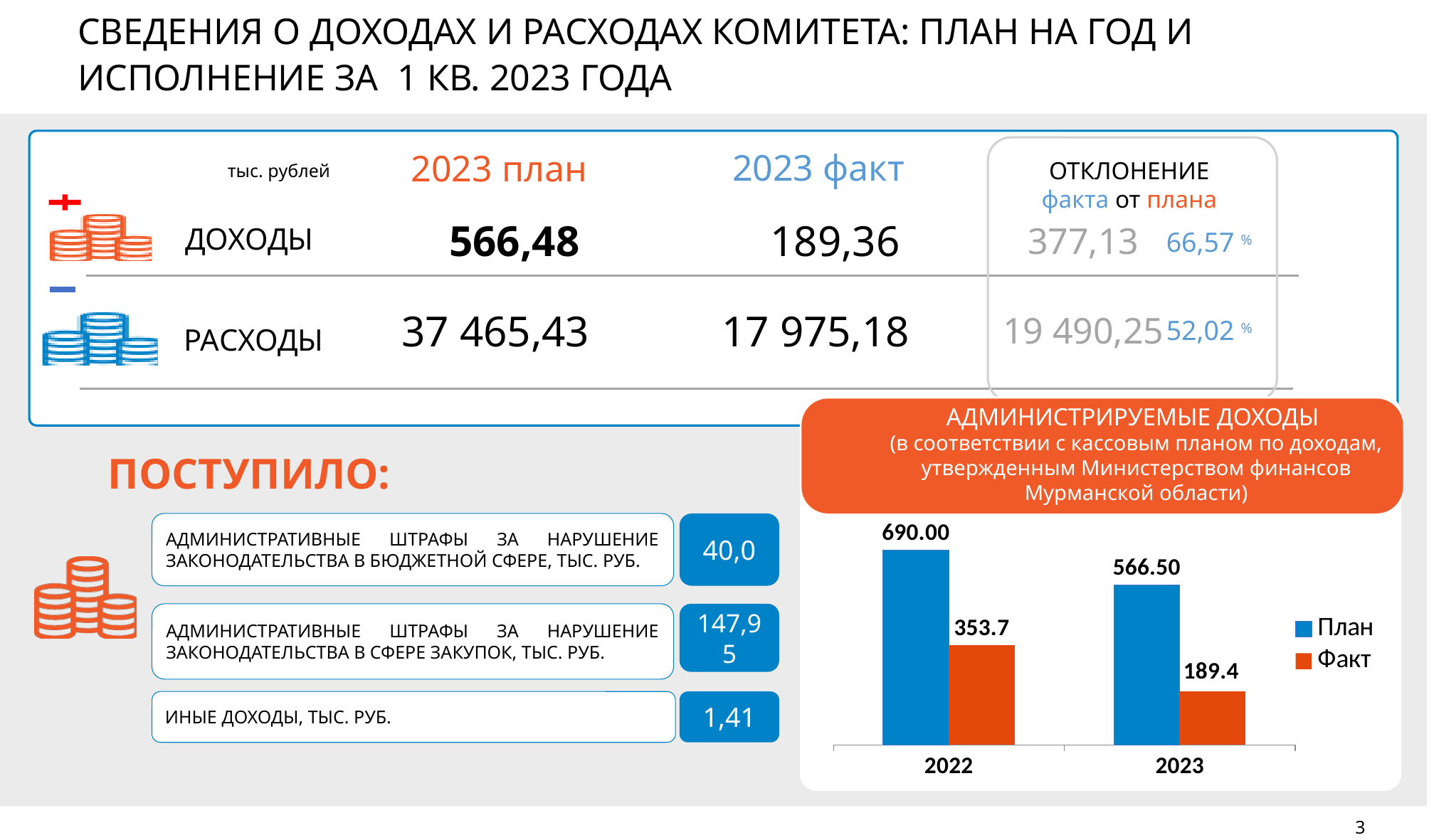
In the bar chart, what is the value of 'План' for 2023? 566.50 In the bar chart, what is the value of 'Факт' for 2022? 353.7 How many series does the legend of the bar chart list? 2 In the bar chart, which year has the lowest 'Факт' value? 2023 In the bar chart, does the 'План' series rise or fall from 2022 to 2023? fall What type of chart is shown under the heading 'АДМИНИСТРИРУЕМЫЕ ДОХОДЫ'? bar chart In the bar chart, is the 'Факт' value for 2022 larger or smaller than the 'Факт' value for 2023? larger In the bar chart, what is the difference between 'План' and 'Факт' for 2022? 336.3 In the bar chart, which year has the highest 'План' value? 2022 In the bar chart, what is the value of 'Факт' for 2023? 189.4 How many categories are shown on the x axis of the bar chart? 2 In the bar chart, what is the value of 'План' for 2022? 690.00